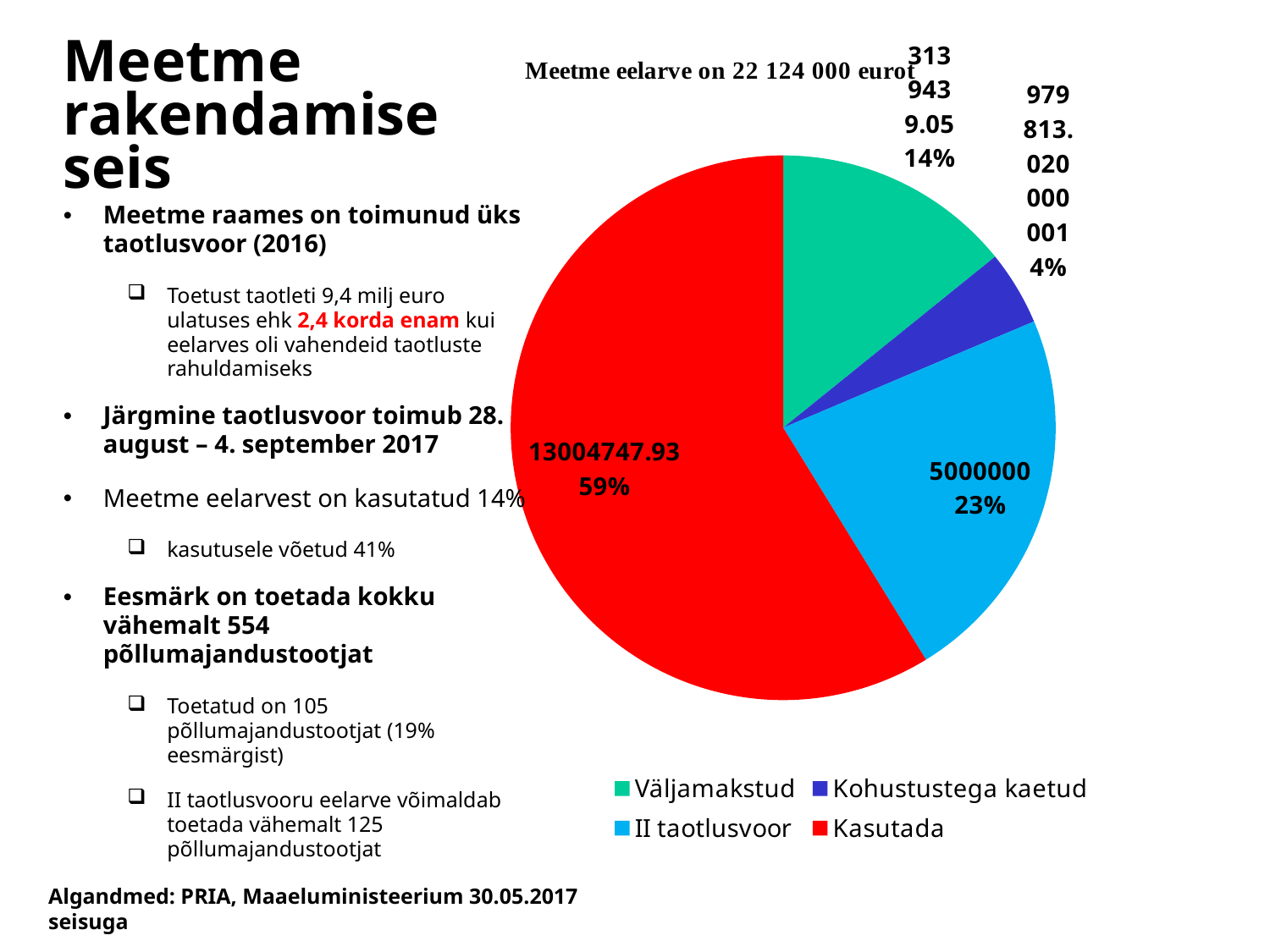
What share of the pie does the Väljamakstud slice represent? 14% What share of the pie does the II taotlusvoor slice represent? 23% How many entries does the legend of the pie chart list? 4 What value is shown for the II taotlusvoor slice of the pie chart? 5000000 What share of the pie does the Kohustustega kaetud slice represent? 4% What kind of chart is shown on the slide? pie chart Which slice of the pie chart is the largest? Kasutada What value is shown for the Kasutada slice of the pie chart? 13004747.93 Which slice of the pie chart is the smallest? Kohustustega kaetud What is the title of the pie chart? Meetme eelarve on 22 124 000 eurot How many slices does the pie chart have? 4